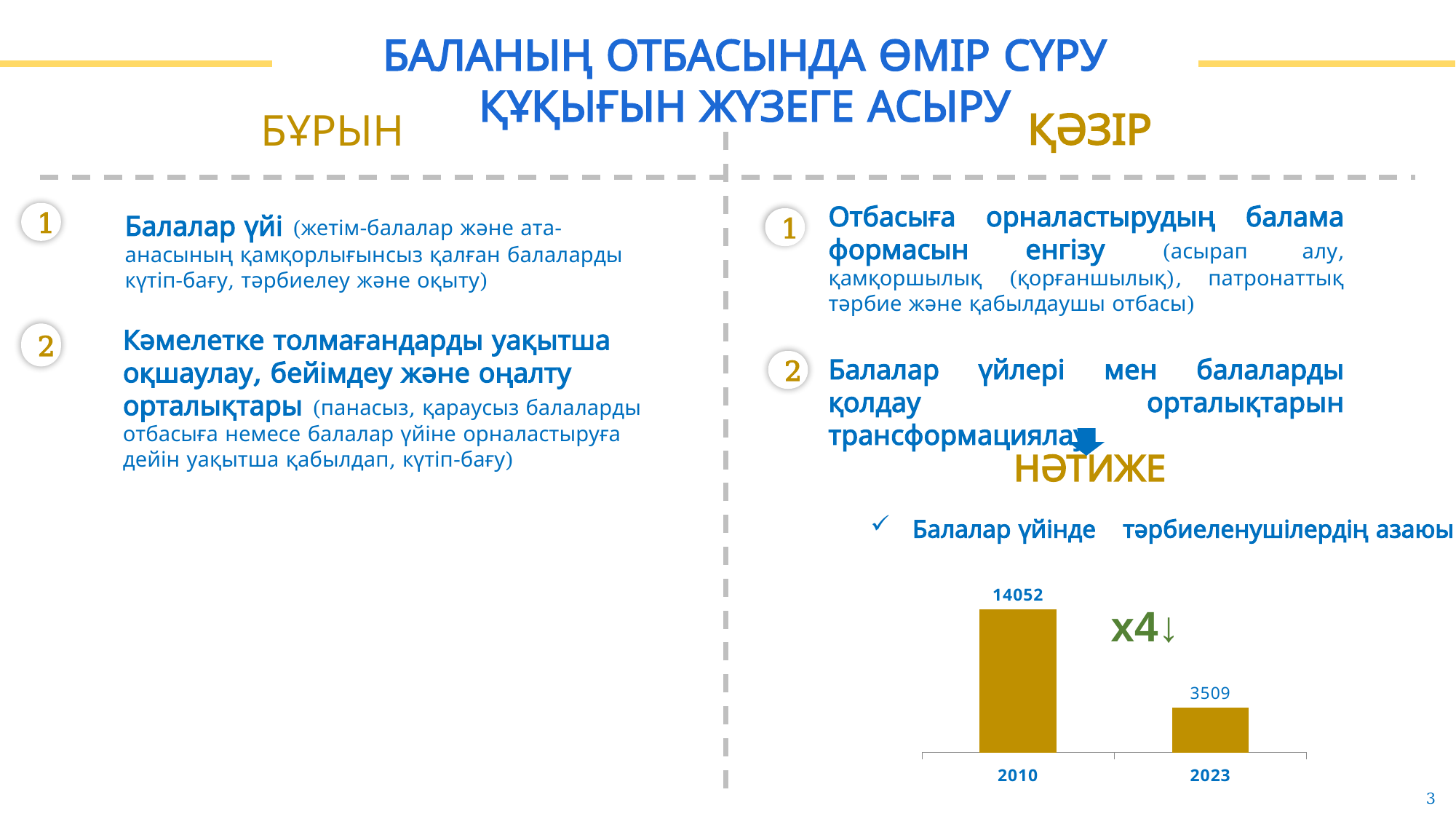
What is the difference between the 2010 and 2023 values in the bar chart? 10543 What is the value shown for 2010 in the bar chart? 14052 What factor of decrease is annotated next to the bar chart? x4 What is the value shown for 2023 in the bar chart? 3509 Is the value for 2023 larger or smaller than the value for 2010? smaller What type of chart is shown on the slide? bar chart Which year has the lower value in the bar chart? 2023 Do the values in the chart rise or fall from 2010 to 2023? fall How many bars are shown in the chart? 2 Which year has the higher value in the bar chart? 2010 What colour are the bars in the chart? gold